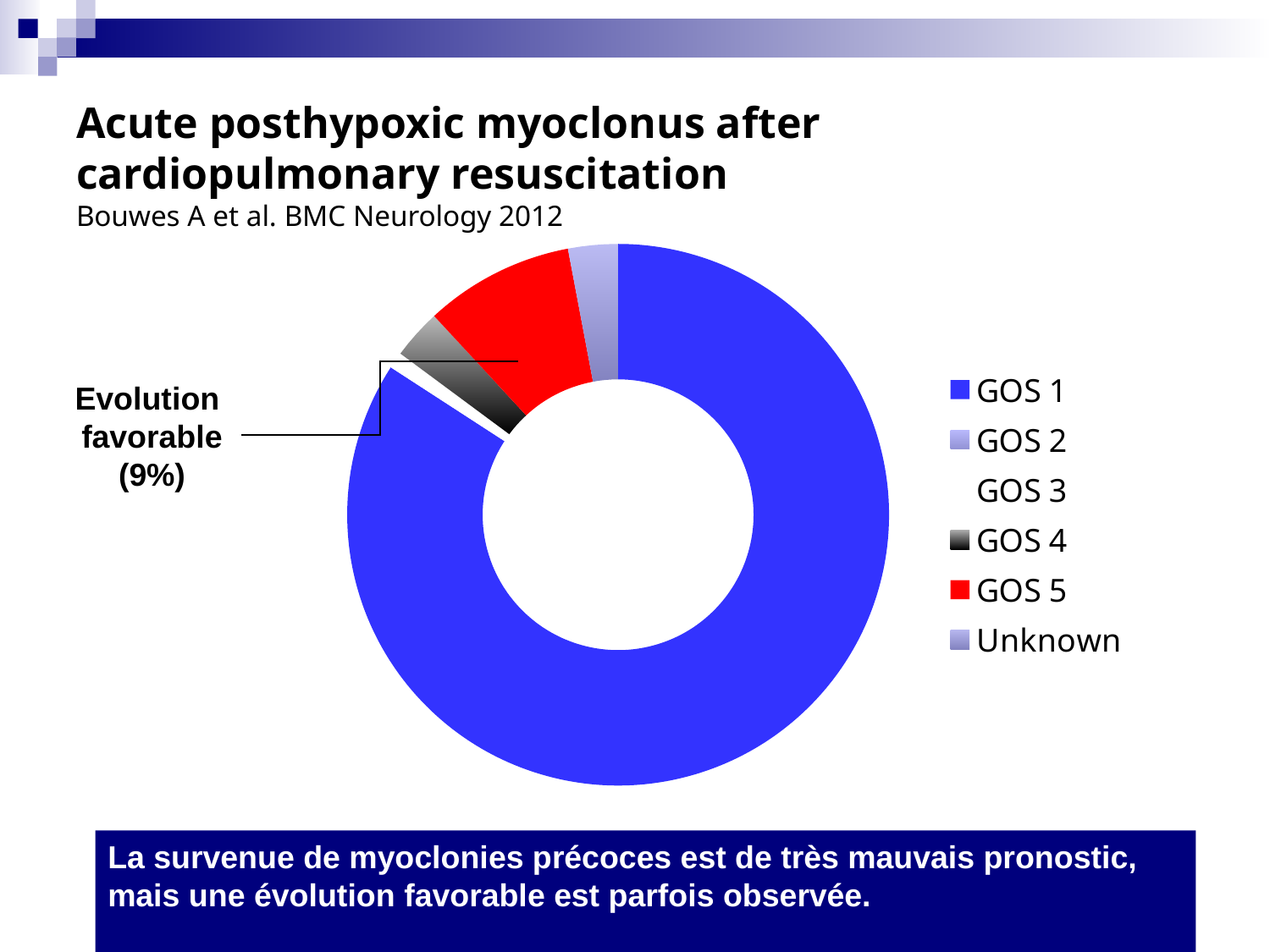
What colour represents GOS 1 in the chart? Blue Which is larger in the chart, GOS 5 or GOS 4? GOS 5 What percentage is given on the slide for 'Evolution favorable'? 9% What kind of chart is shown on the slide? Doughnut (pie) chart What colour represents GOS 5 in the chart? Red Which category has the largest share of the chart? GOS 1 How many categories does the legend of the chart list? 6 Which is larger in the chart, GOS 1 or GOS 5? GOS 1